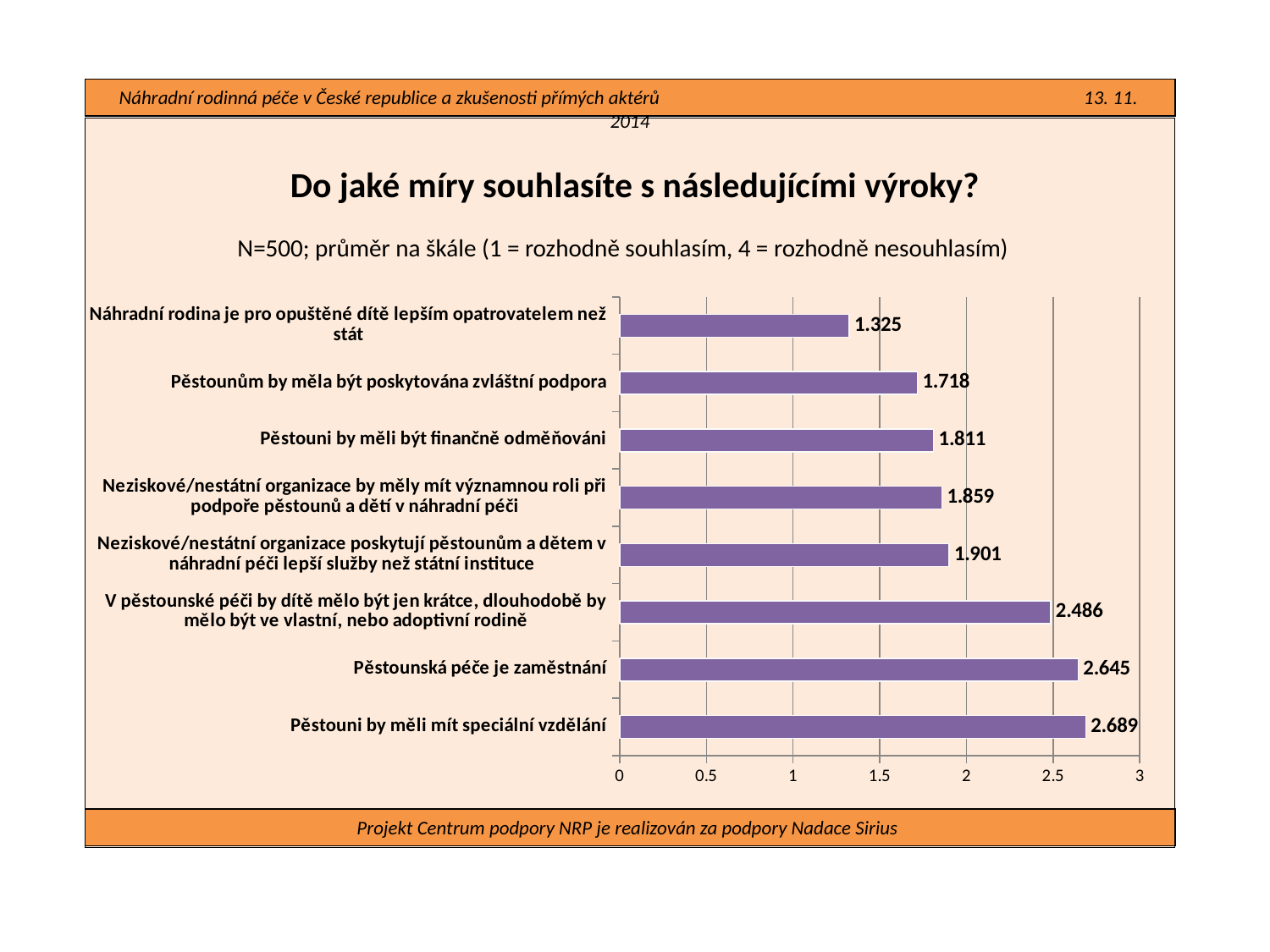
What is the sample size (N) stated in the chart subtitle? N=500 What kind of chart is shown on the slide? bar chart What is the difference between the values for "Pěstounská péče je zaměstnání" and "V pěstounské péči by dítě mělo být jen krátce, dlouhodobě by mělo být ve vlastní, nebo adoptivní rodině"? 0.159 Which statement has the highest value? Pěstouni by měli mít speciální vzdělání What is the difference between the values for "Pěstouni by měli mít speciální vzdělání" and "Náhradní rodina je pro opuštěné dítě lepším opatrovatelem než stát"? 1.364 What is the value for "Pěstouni by měli být finančně odměňováni"? 1.811 Which has a larger value: "Pěstouni by měli být finančně odměňováni" or "Pěstounům by měla být poskytována zvláštní podpora"? Pěstouni by měli být finančně odměňováni Is the value for "V pěstounské péči by dítě mělo být jen krátce, dlouhodobě by mělo být ve vlastní, nebo adoptivní rodině" greater or less than 2? greater Which statement has the lowest value? Náhradní rodina je pro opuštěné dítě lepším opatrovatelem než stát What is the value for "Pěstounům by měla být poskytována zvláštní podpora"? 1.718 What is the value for "Pěstounská péče je zaměstnání"? 2.645 How many statements are shown in the chart? 8